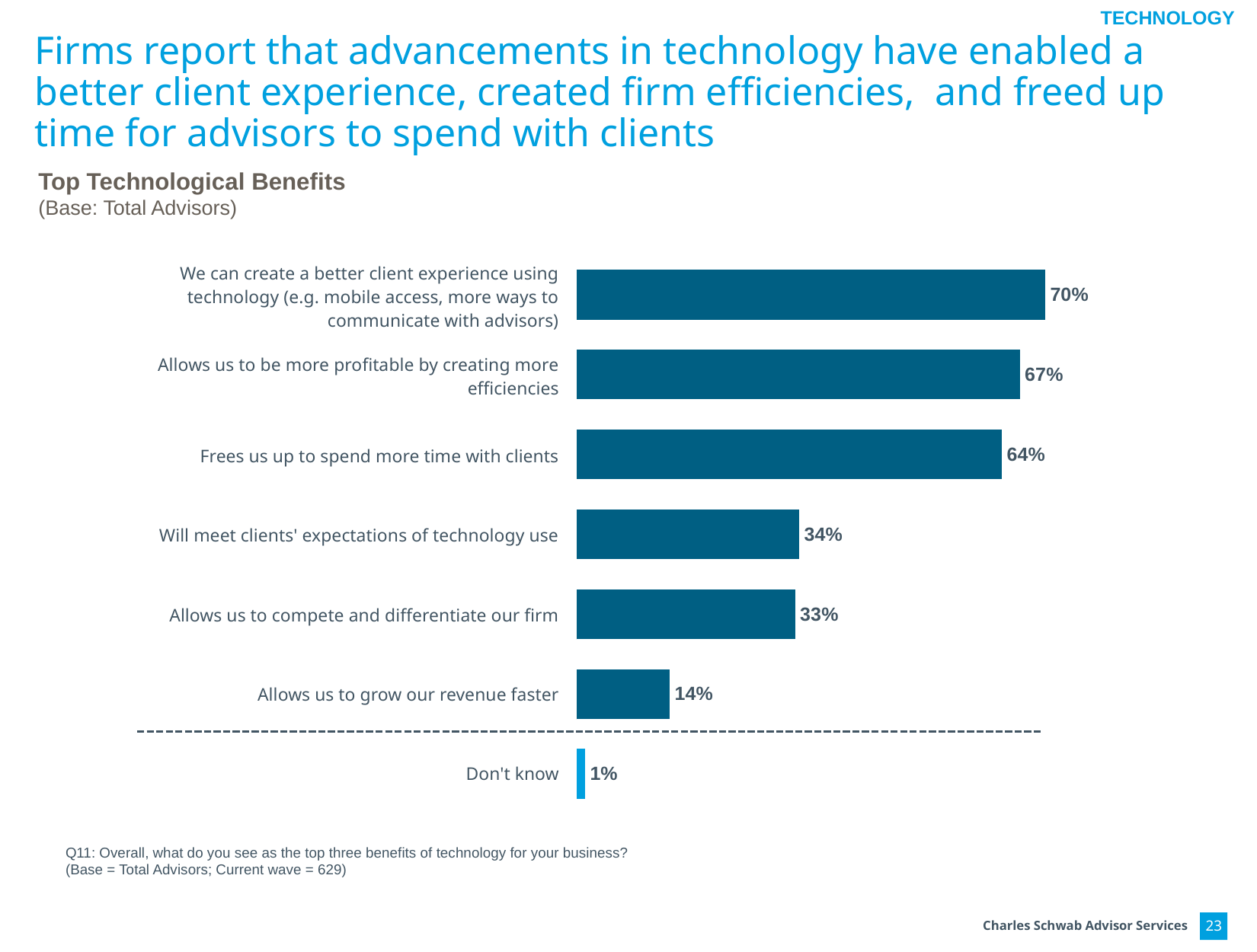
What percentage of advisors selected "Allows us to grow our revenue faster"? 14% What is the value for "Frees us up to spend more time with clients"? 64% What is the title of the chart? Top Technological Benefits Which technological benefit has the highest percentage? We can create a better client experience using technology Excluding "Don't know", which benefit has the lowest percentage? Allows us to grow our revenue faster What type of chart is shown on the slide? Bar chart Which is larger: "Will meet clients' expectations of technology use" or "Allows us to compete and differentiate our firm"? Will meet clients' expectations of technology use How many categories are shown in the chart, including "Don't know"? 7 What percentage of advisors said technology allows them to create a better client experience? 70% What is the value for "Don't know"? 1% What is the difference between the highest benefit (70%) and "Frees us up to spend more time with clients"? 6 percentage points What is the difference between "Allows us to be more profitable by creating more efficiencies" and "Will meet clients' expectations of technology use"? 33 percentage points